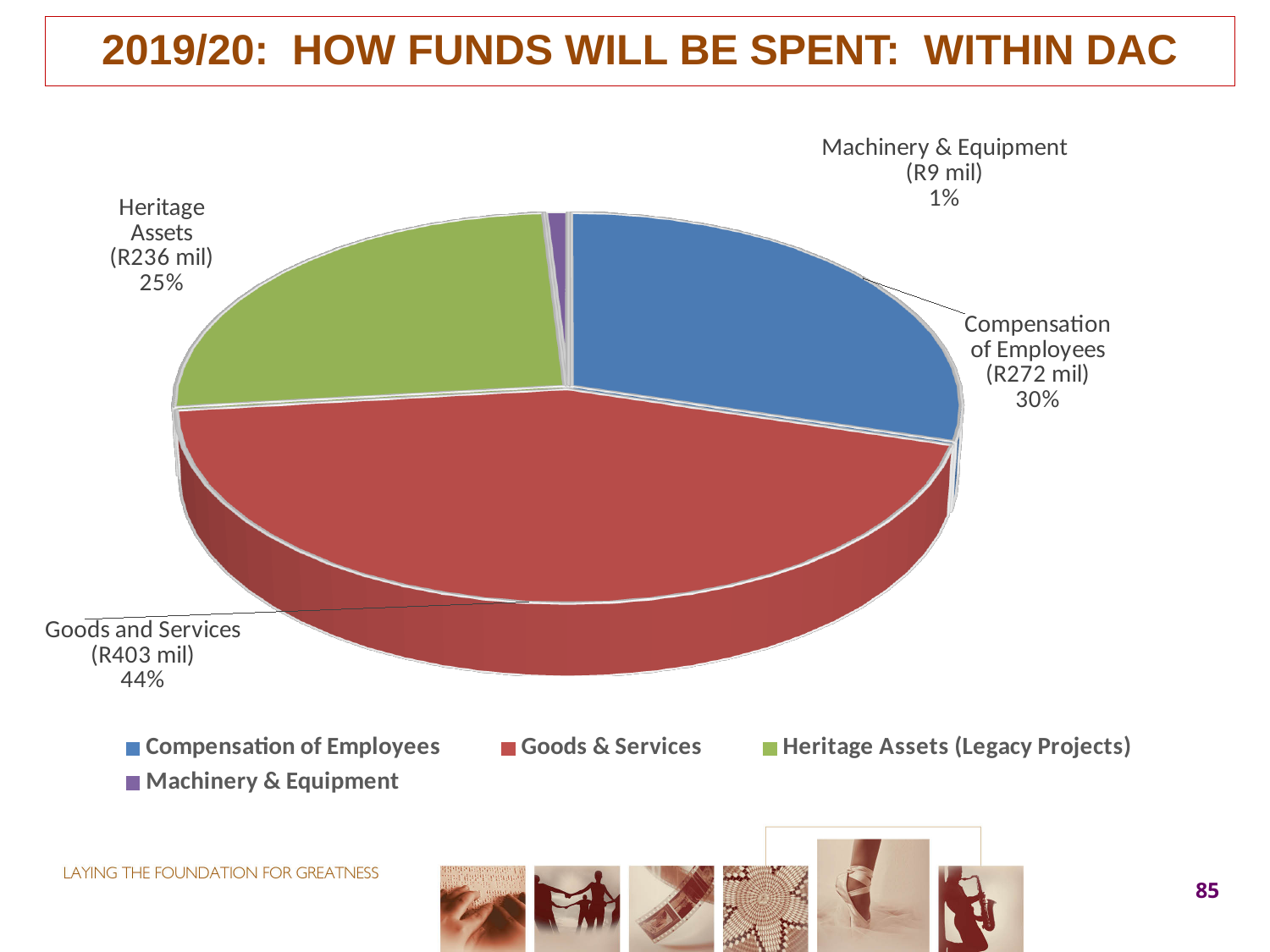
What kind of chart is shown on the slide? pie chart How many entries does the legend list? 4 What percentage share does Compensation of Employees have? 30% What colour is the Goods & Services slice? red What is the difference in value between Compensation of Employees and Heritage Assets? R36 mil What is the value for Heritage Assets? R236 mil Which is larger, Compensation of Employees or Heritage Assets? Compensation of Employees Which category has the largest slice? Goods and Services What is the value for Goods and Services? R403 mil How many slices does the pie chart have? 4 Which category has the smallest slice? Machinery & Equipment What percentage share does Machinery & Equipment have? 1%